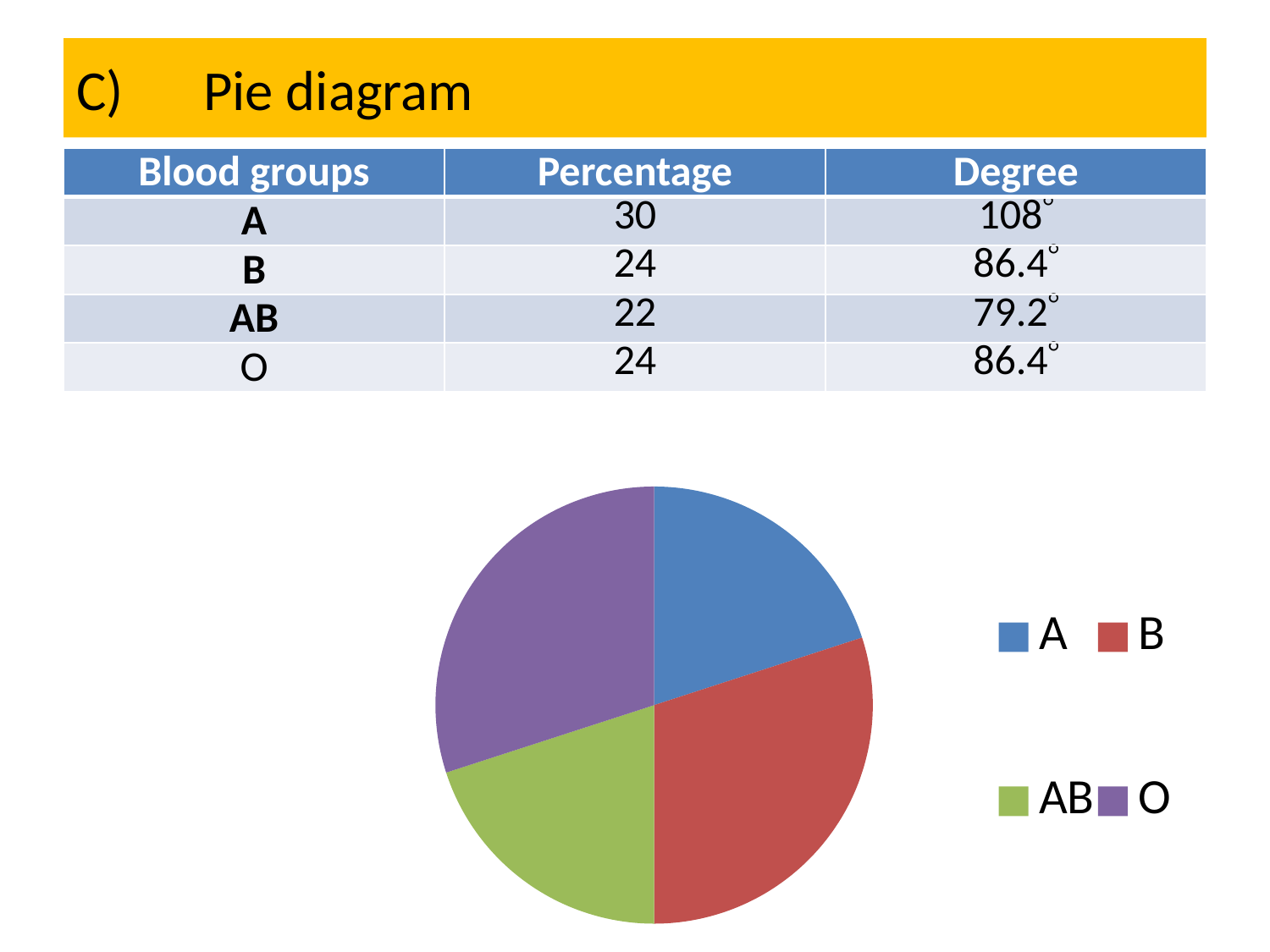
In the pie chart, which slice is larger, AB or B? B What kind of chart is shown on the slide? pie chart How many slices does the pie chart have? 4 In the pie chart, which slice is larger, B or A? B Which blood groups are listed in the pie chart's legend? A, B, AB, O According to the table on the slide, what is the degree value for blood group AB? 79.2° What colour is the slice for blood group O in the pie chart? purple In the pie chart, which slice is larger, O or AB? O How many entries does the pie chart's legend list? 4 According to the table on the slide, what is the percentage for blood group A? 30